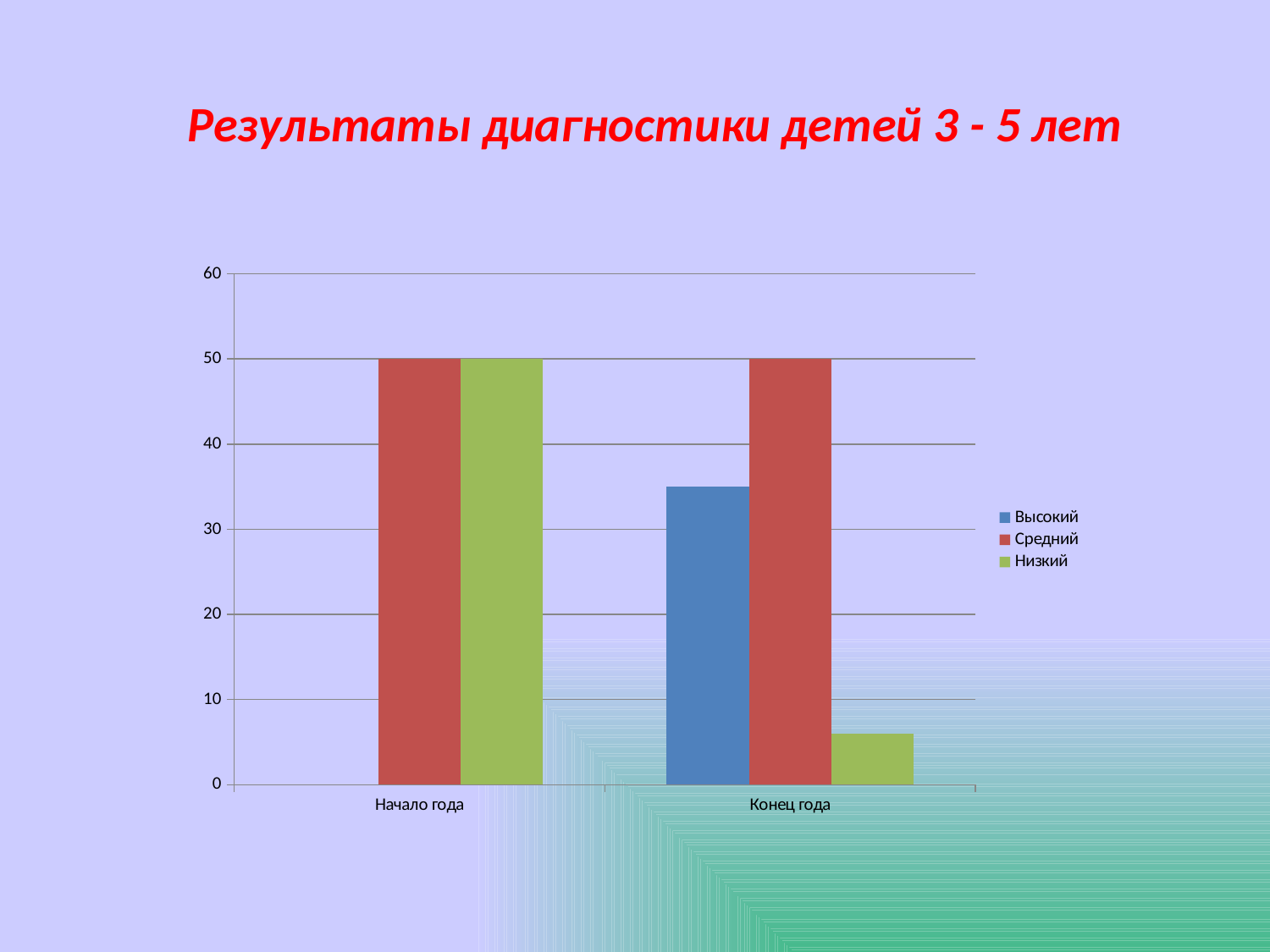
How many series does the legend list? 3 Is the value for Низкий at Конец года greater or less than 10? less Does the value for Низкий rise or fall from Начало года to Конец года? fall How many categories are shown on the x axis? 2 What is the value for Средний at Конец года? 50 Which series has the lowest value at Конец года? Низкий Is the value for Высокий at Конец года greater or less than 40? less Is the value for Высокий at Конец года greater or less than 30? greater Which is larger: the value for Низкий at Начало года or at Конец года? Начало года What is the value for Средний at Начало года? 50 What is the value for Низкий at Начало года? 50 What kind of chart is shown on the slide? bar chart